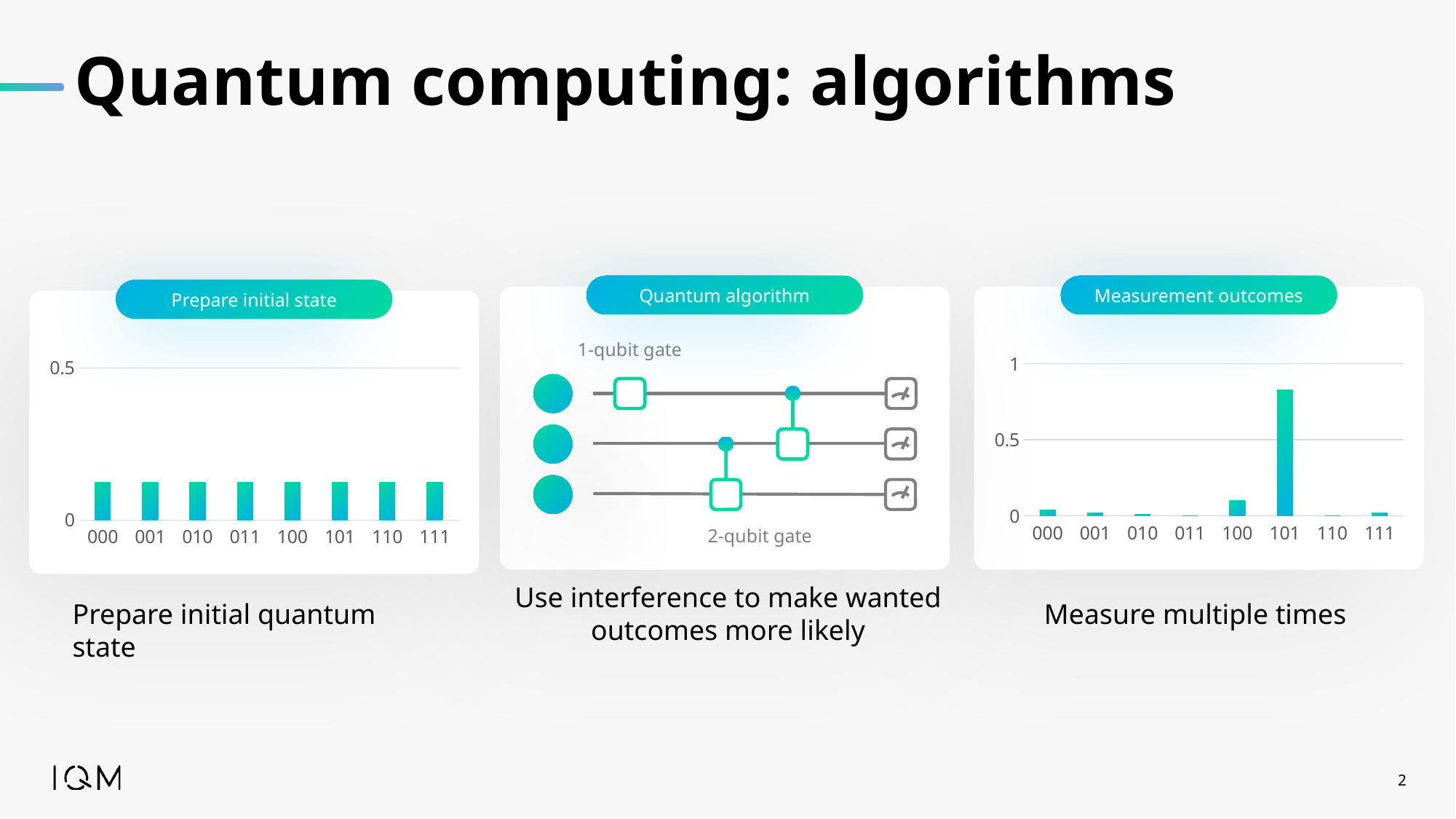
In the 'Measurement outcomes' chart, which is larger, the value for 101 or the value for 100? 101 In the 'Measurement outcomes' chart, how many categories are shown on the x axis? 8 In the 'Measurement outcomes' chart, what is the highest tick label shown on the y axis? 1 In the 'Prepare initial state' chart, is the value for 000 greater or less than 0.5? less What kind of chart is shown under the 'Prepare initial state' heading? bar chart In the 'Measurement outcomes' chart, is the value for 100 greater or less than 0.5? less What kind of chart is shown under the 'Measurement outcomes' heading? bar chart In the 'Measurement outcomes' chart, which category has the highest value? 101 In the 'Prepare initial state' chart, how many categories are shown on the x axis? 8 In the 'Prepare initial state' chart, do the bar heights rise, fall, or stay the same across the x axis? stay the same In the 'Measurement outcomes' chart, is the value for 101 greater or less than 0.5? greater In the 'Prepare initial state' chart, what is the highest tick label shown on the y axis? 0.5